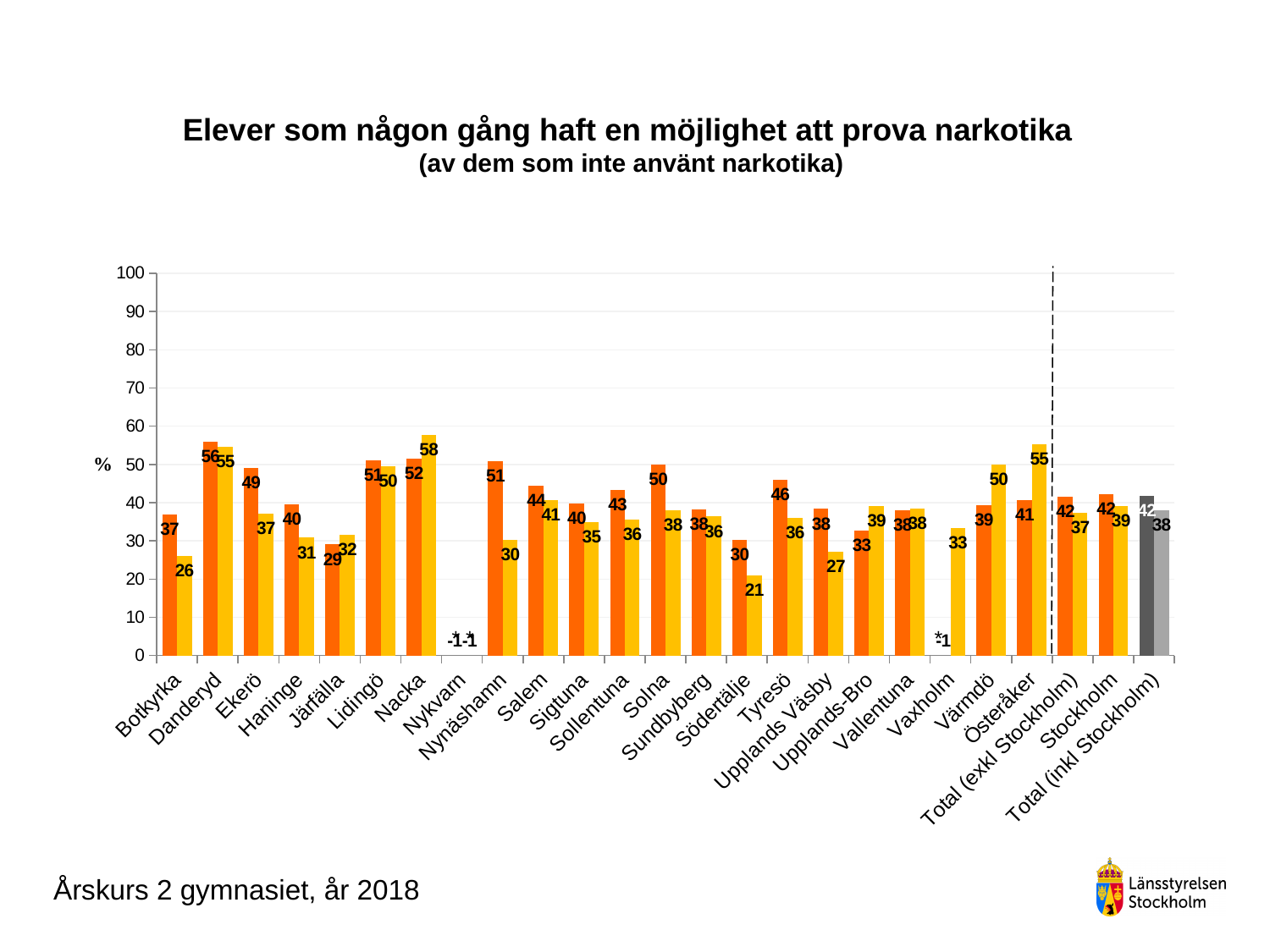
What type of chart is shown on the slide? bar chart Which municipality has the highest yellow bar? Nacka Is the orange bar for Ekerö greater or less than 40? greater What is the value of the yellow bar for Nacka? 58 How many categories are shown on the x axis? 25 What is the difference between the orange and yellow bars for Nynäshamn? 21 Which is larger for Österåker, the orange bar or the yellow bar? the yellow bar What is the value of the orange bar for Danderyd? 56 Which municipality has the lowest yellow bar (excluding Nykvarn and Vaxholm)? Södertälje What is the title of the chart? Elever som någon gång haft en möjlighet att prova narkotika (av dem som inte använt narkotika) What is the value of the yellow bar for Södertälje? 21